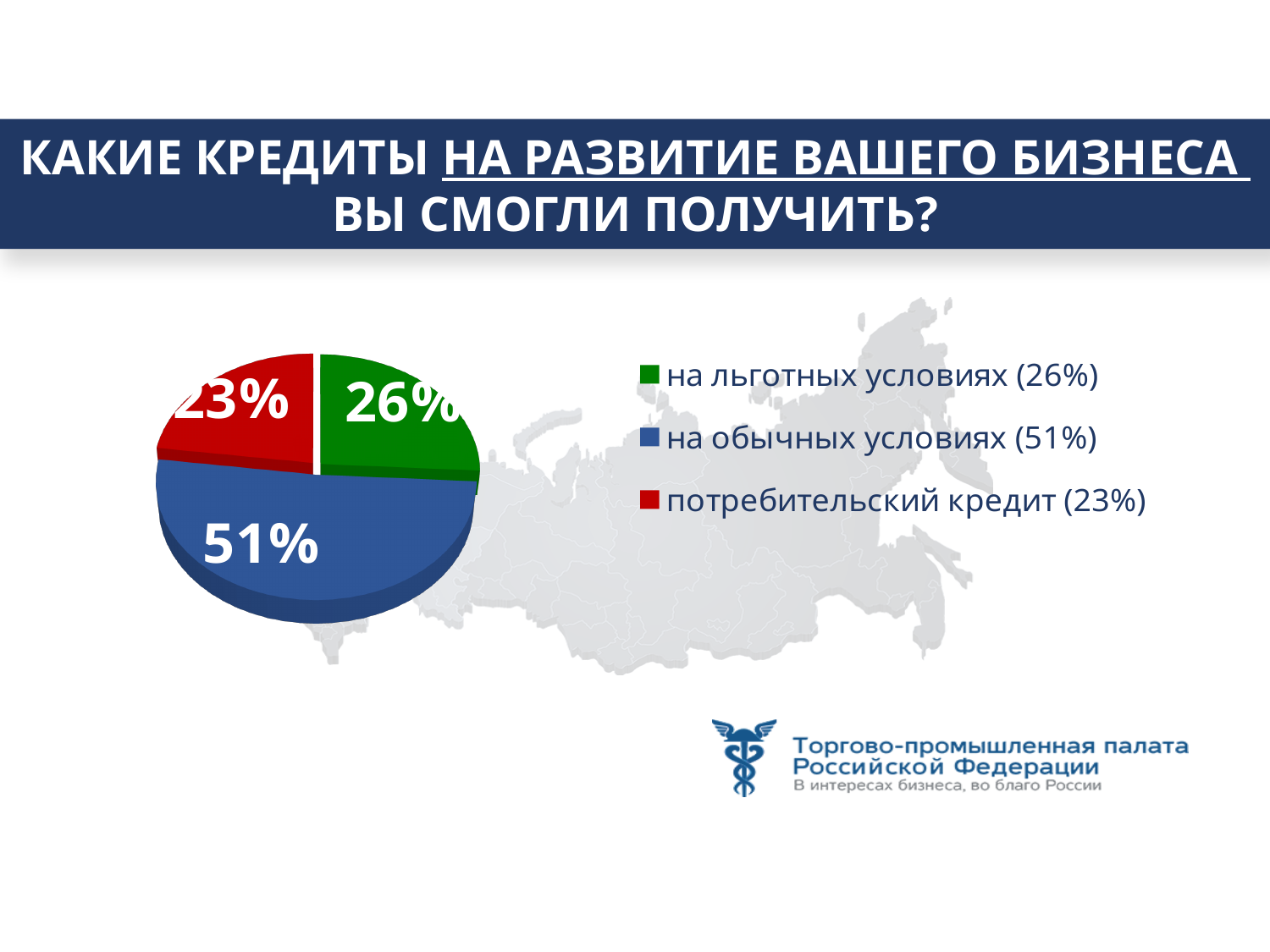
What share of the pie is "на льготных условиях"? 26% Which category has the largest slice of the pie? на обычных условиях Which category has the smallest slice of the pie? потребительский кредит What kind of chart is shown on the slide? pie chart What is the difference in percentage points between "на обычных условиях" and "на льготных условиях"? 25 How many slices does the pie chart have? 3 What is the difference in percentage points between "на льготных условиях" and "потребительский кредит"? 3 What colour is the slice for "на обычных условиях"? blue Which is larger: "на льготных условиях" or "потребительский кредит"? на льготных условиях What share of the pie is "потребительский кредит"? 23% What colour is the slice for "потребительский кредит"? red What share of the pie is "на обычных условиях"? 51%